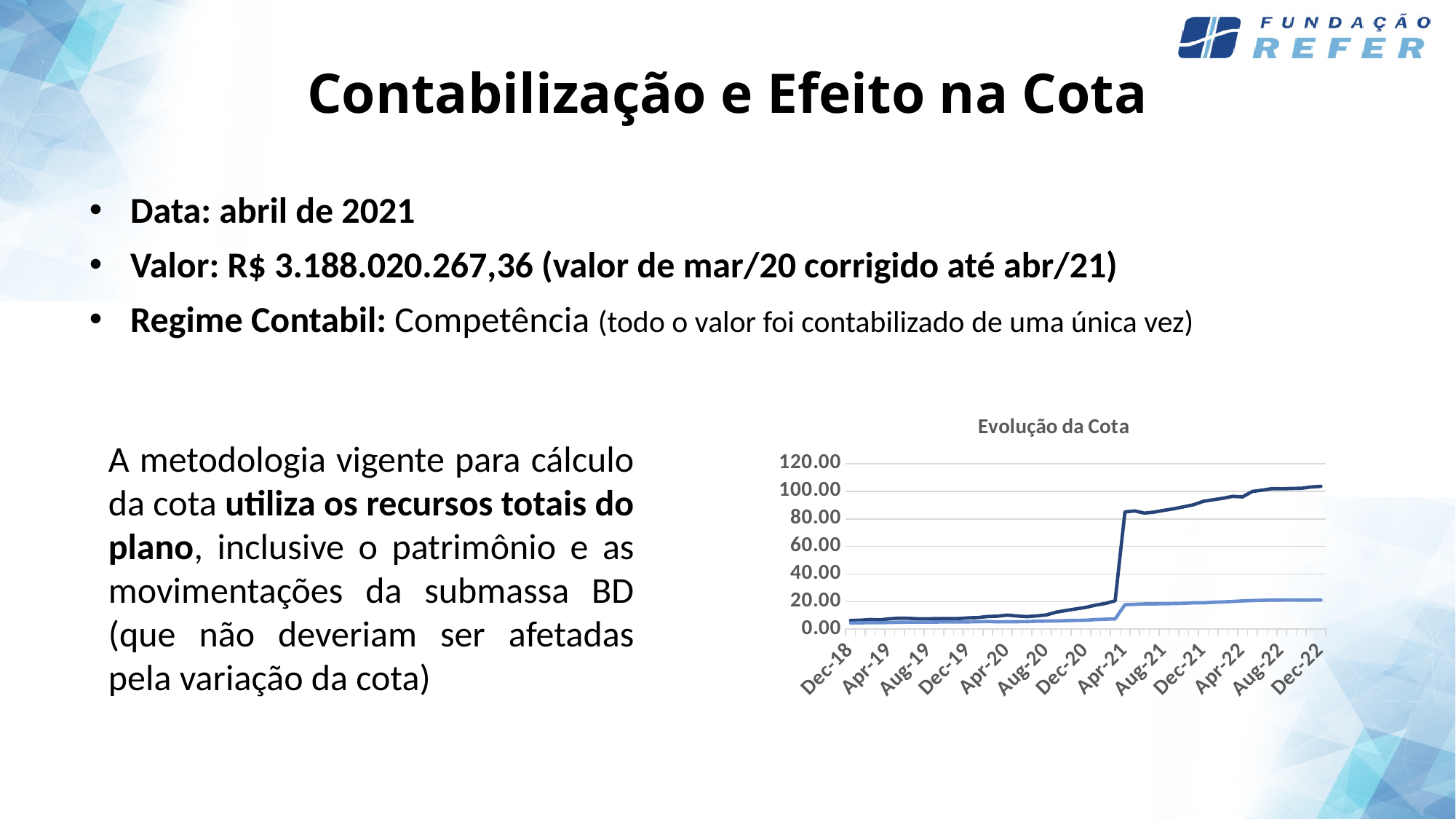
In the Evolução da Cota chart, is the value of the dark blue line at Apr-21 greater or less than 60? greater In the Evolução da Cota chart, is the value of the light blue line at Dec-22 greater or less than 40? less Around which x-axis label does the dark blue line in the Evolução da Cota chart show its sharp jump upward? Apr-21 What is the highest value shown on the y axis of the Evolução da Cota chart? 120.00 In the Evolução da Cota chart, is the value of the dark blue line at Dec-20 greater or less than 40? less Does the upper (dark blue) line in the Evolução da Cota chart rise or fall overall from Dec-18 to Dec-22? rise In the Evolução da Cota chart, which line is higher at Dec-22, the dark blue line or the light blue line? the dark blue line What kind of chart is shown on the slide? line chart How many lines are plotted in the Evolução da Cota chart? 2 How many date labels are shown on the x axis of the Evolução da Cota chart? 13 What is the title of the chart on the slide? Evolução da Cota